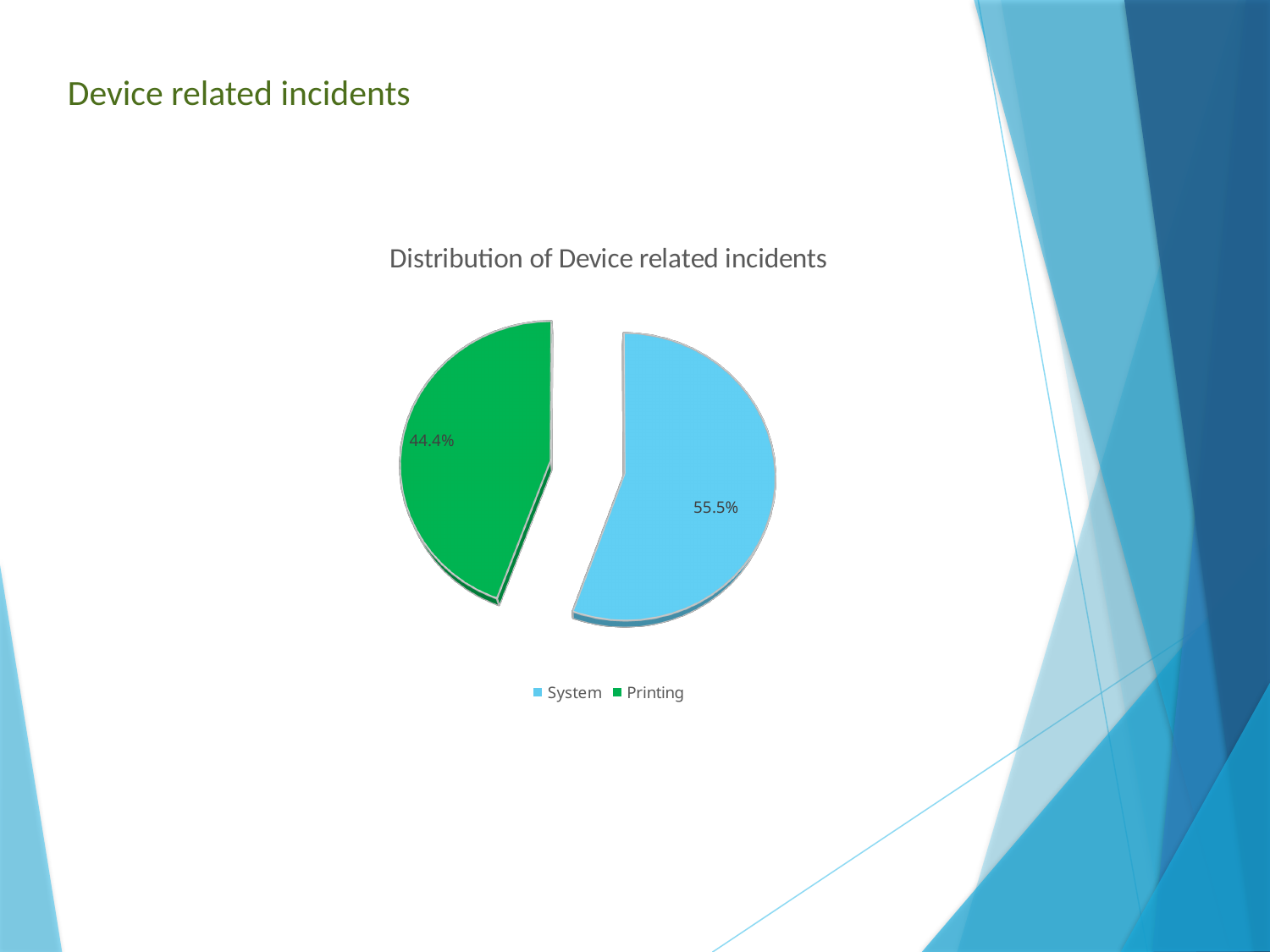
Which category has the smallest slice of the pie? Printing What is the title of the chart? Distribution of Device related incidents What is the difference in percentage points between the System and Printing shares? 11.1 What share of the pie does Printing account for? 44.4% What kind of chart is shown on the slide? pie chart What colour is the Printing slice? green What share of the pie does System account for? 55.5% Which is larger, the share for System or the share for Printing? System How many slices does the pie chart have? 2 Which category has the largest slice of the pie? System